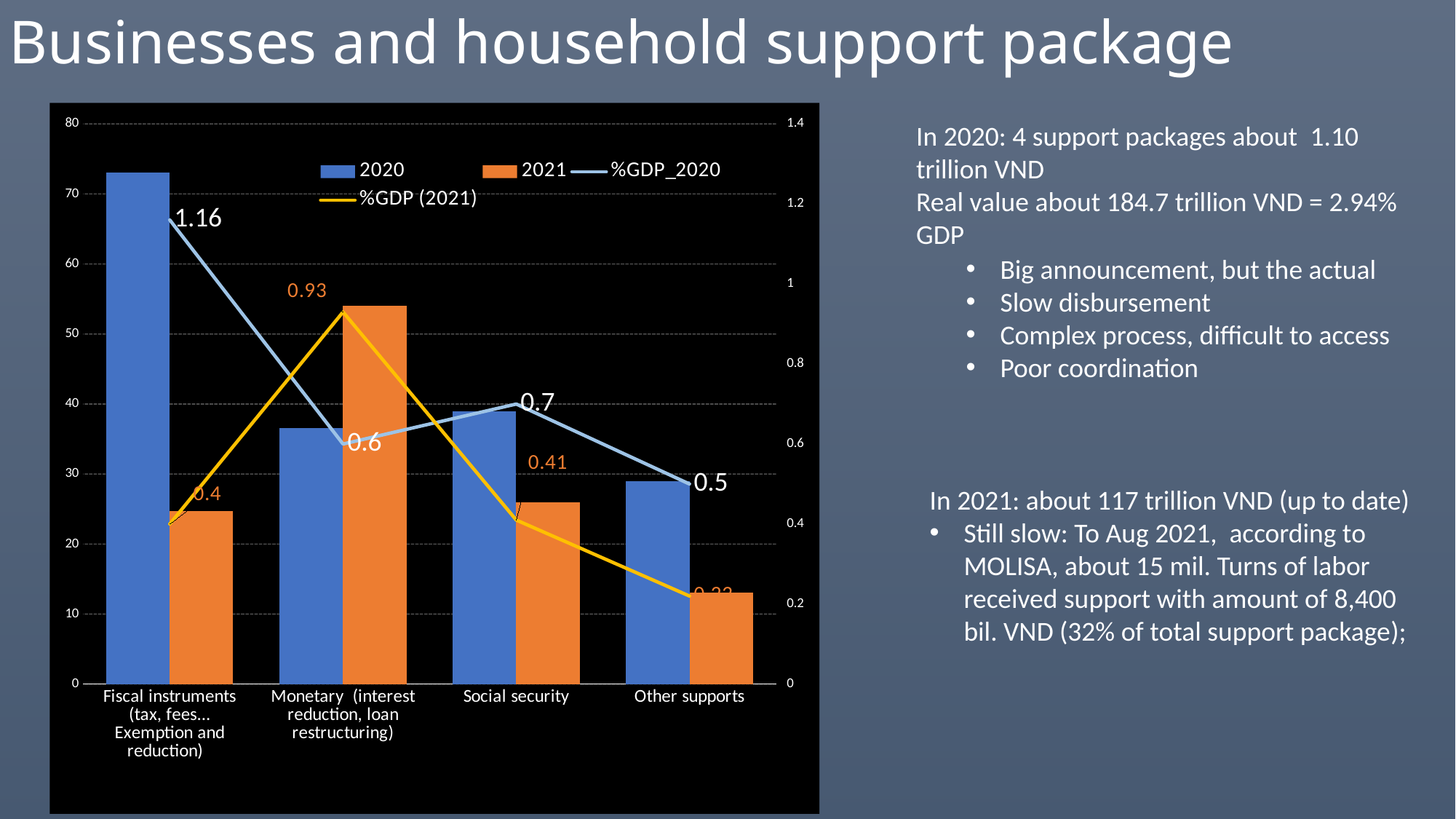
Which category has the tallest 2021 bar? Monetary (interest reduction, loan restructuring) How many categories are shown on the x axis of the chart? 4 Which category has the highest %GDP_2020 value? Fiscal instruments (tax, fees... Exemption and reduction) What is the %GDP_2020 value for Other supports? 0.5 What is the difference between the %GDP_2020 values for Social security and Monetary (interest reduction, loan restructuring)? 0.1 Which category has the lowest %GDP (2021) value? Other supports What is the %GDP (2021) value for Monetary (interest reduction, loan restructuring)? 0.93 Which category has the taller 2020 bar: Fiscal instruments or Monetary? Fiscal instruments (tax, fees... Exemption and reduction) What is the %GDP_2020 value for Fiscal instruments (tax, fees... Exemption and reduction)? 1.16 Is the 2020 bar value for Fiscal instruments greater or less than 70? greater Is the 2021 bar value for Other supports greater or less than 20? less How many series does the chart legend list? 4